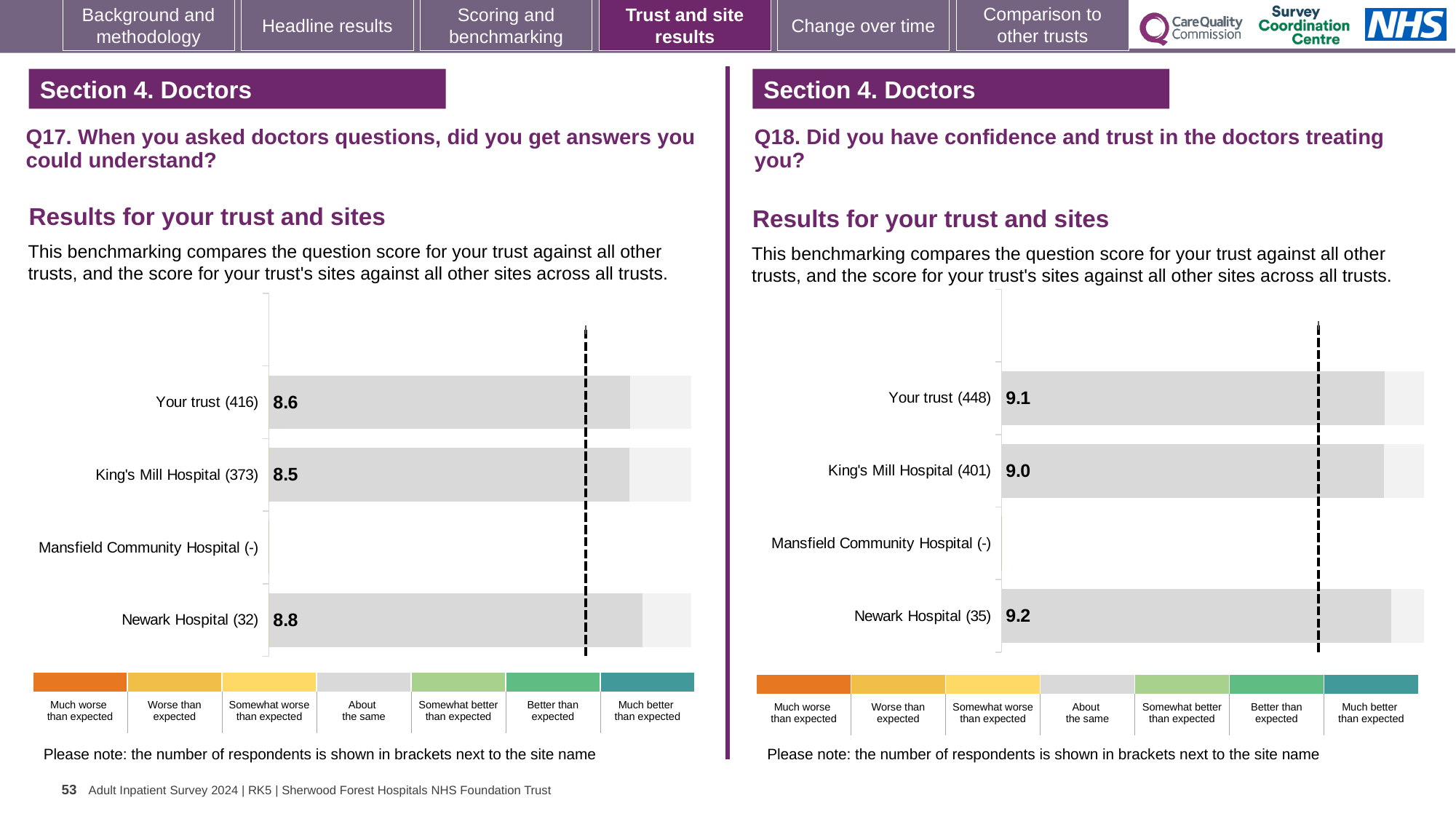
In the Q17 chart on the left, what is the score for Your trust? 8.6 In the Q18 chart on the right, which has the larger score, Your trust or King's Mill Hospital? Your trust In the Q17 chart on the left, which site or trust has the lowest score shown? King's Mill Hospital What kind of chart is used in the Q17 chart on the left? Bar chart How many categories (trust and sites) are listed on the y axis of the Q17 chart on the left? 4 In the Q18 chart on the right, which site or trust has the highest score? Newark Hospital In the Q17 chart on the left, what is the score for Newark Hospital? 8.8 In the Q18 chart on the right, what is the score for Newark Hospital? 9.2 How many respondents are shown in brackets for Your trust in the Q18 chart on the right? 448 In the Q17 chart on the left, what is the score for King's Mill Hospital? 8.5 In the Q17 chart on the left, what is the difference between the Newark Hospital score and the King's Mill Hospital score? 0.3 In the Q18 chart on the right, what is the score for Your trust? 9.1